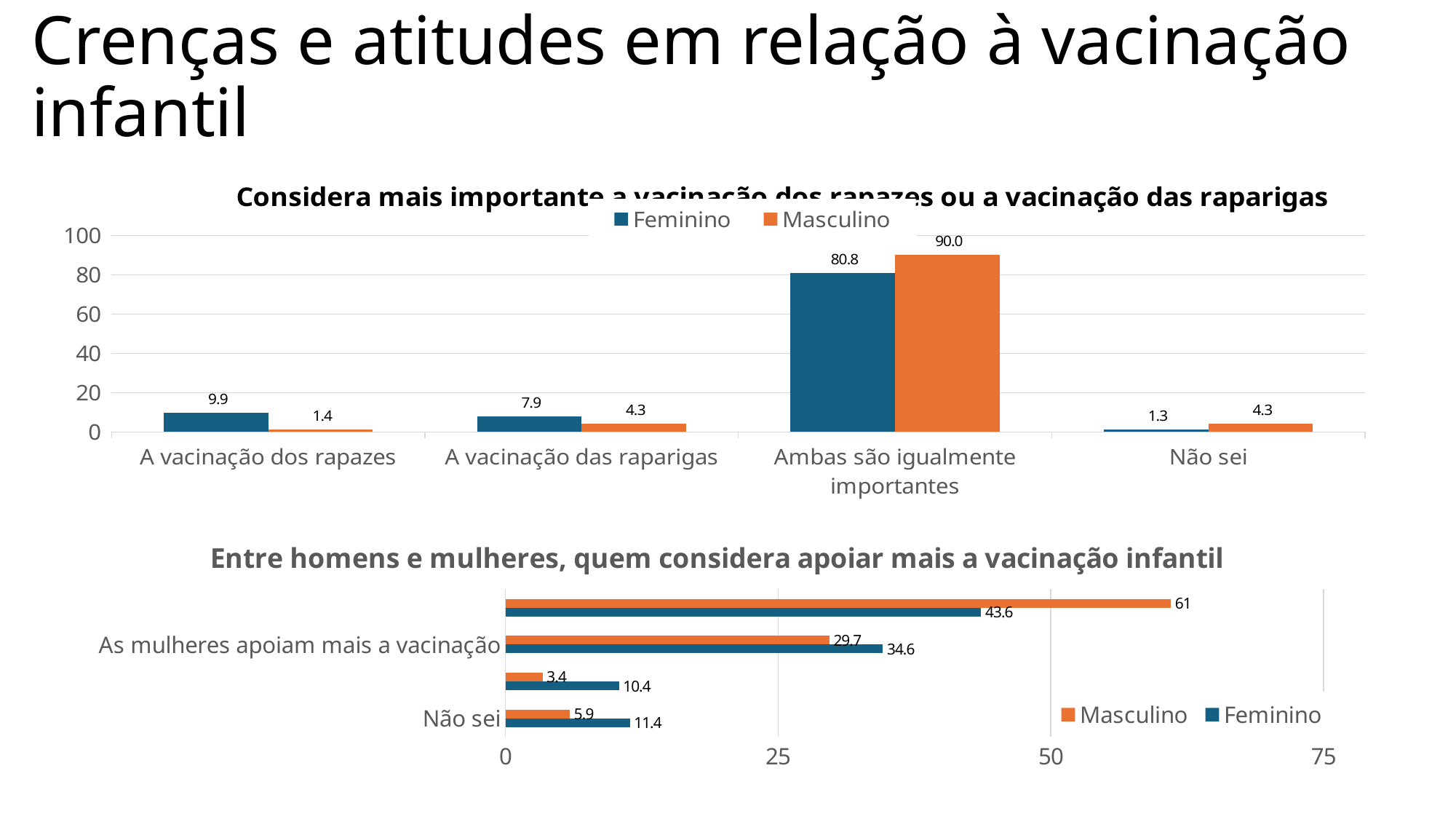
In the top chart, what is the difference between the Masculino and Feminino values for 'Ambas são igualmente importantes'? 9.2 In the bottom chart, what is the Masculino value for 'Não sei'? 5.9 How many categories are shown on the x axis of the top chart? 4 In the top chart, what is the Masculino value for 'Não sei'? 4.3 What kind of chart is the bottom chart? Bar chart In the bottom chart 'Entre homens e mulheres, quem considera apoiar mais a vacinação infantil', what is the Feminino value for 'As mulheres apoiam mais a vacinação'? 34.6 In the top chart 'Considera mais importante a vacinação dos rapazes ou a vacinação das raparigas', what is the Masculino value for 'Ambas são igualmente importantes'? 90.0 How many series does the legend of the top chart list? 2 In the top chart, which category has the highest Feminino value? Ambas são igualmente importantes In the top chart, which category has the lowest Masculino value? A vacinação dos rapazes In the top chart, for 'A vacinação das raparigas', which series has the larger value, Feminino or Masculino? Feminino In the top chart, what is the Feminino value for 'A vacinação dos rapazes'? 9.9